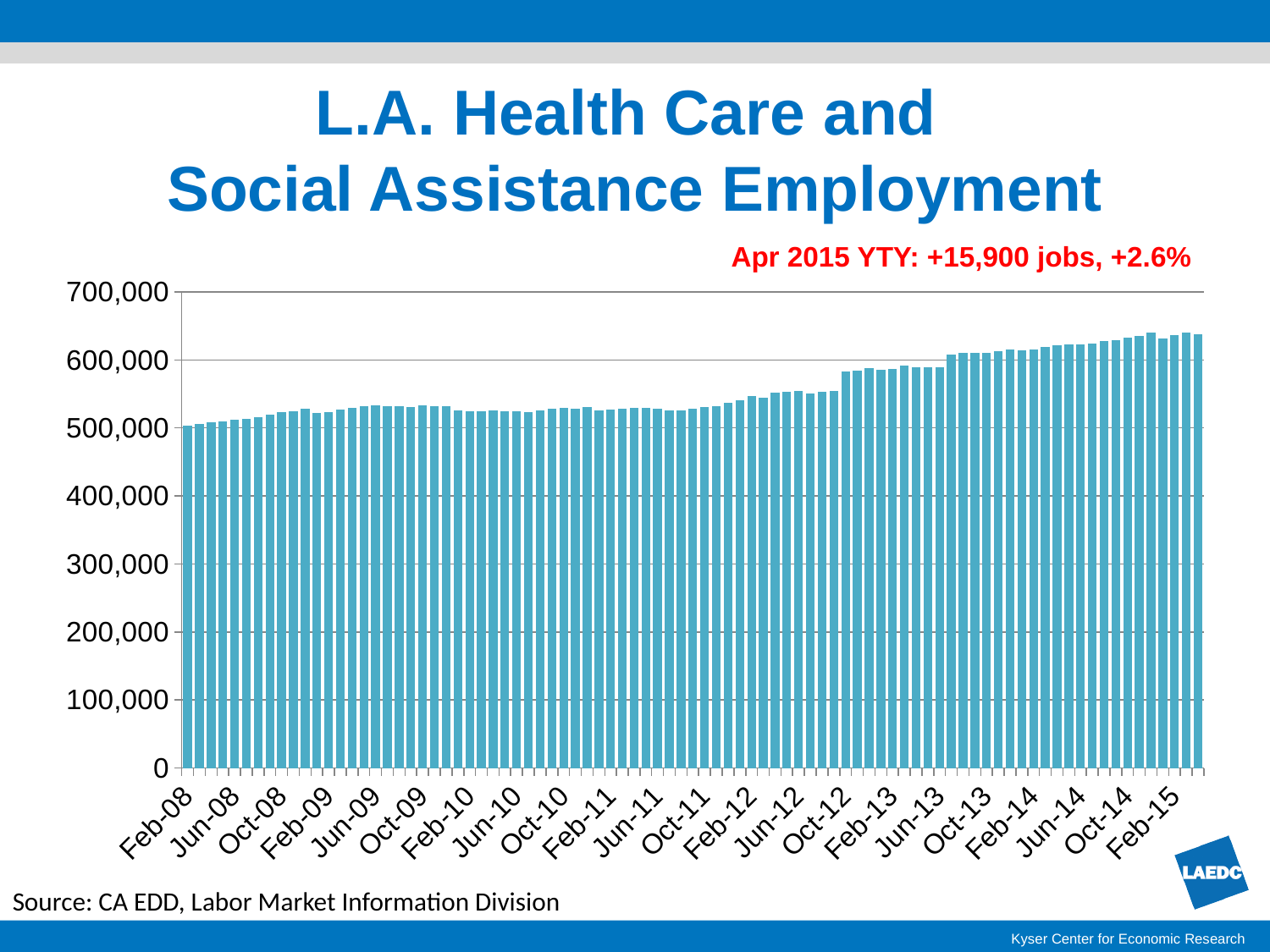
Which month has the lowest employment value in the chart? Feb-08 What is the title of the chart on the slide? L.A. Health Care and Social Assistance Employment Which is larger, the employment value for Jun-12 or for Jun-14? Jun-14 Is the employment value for Feb-08 greater or less than 600,000? less Is the employment value for Oct-10 greater or less than 500,000? greater Which is larger, the employment value for Feb-15 or for Feb-08? Feb-15 Is the employment value for Feb-15 greater or less than 600,000? greater According to the annotation on the slide, what was the Apr 2015 year-to-year change in jobs? +15,900 jobs, +2.6% Overall, do the employment values rise or fall from Feb-08 to Feb-15? Rise What kind of chart is shown on the slide? Bar chart What is the highest value shown on the vertical axis of the chart? 700,000